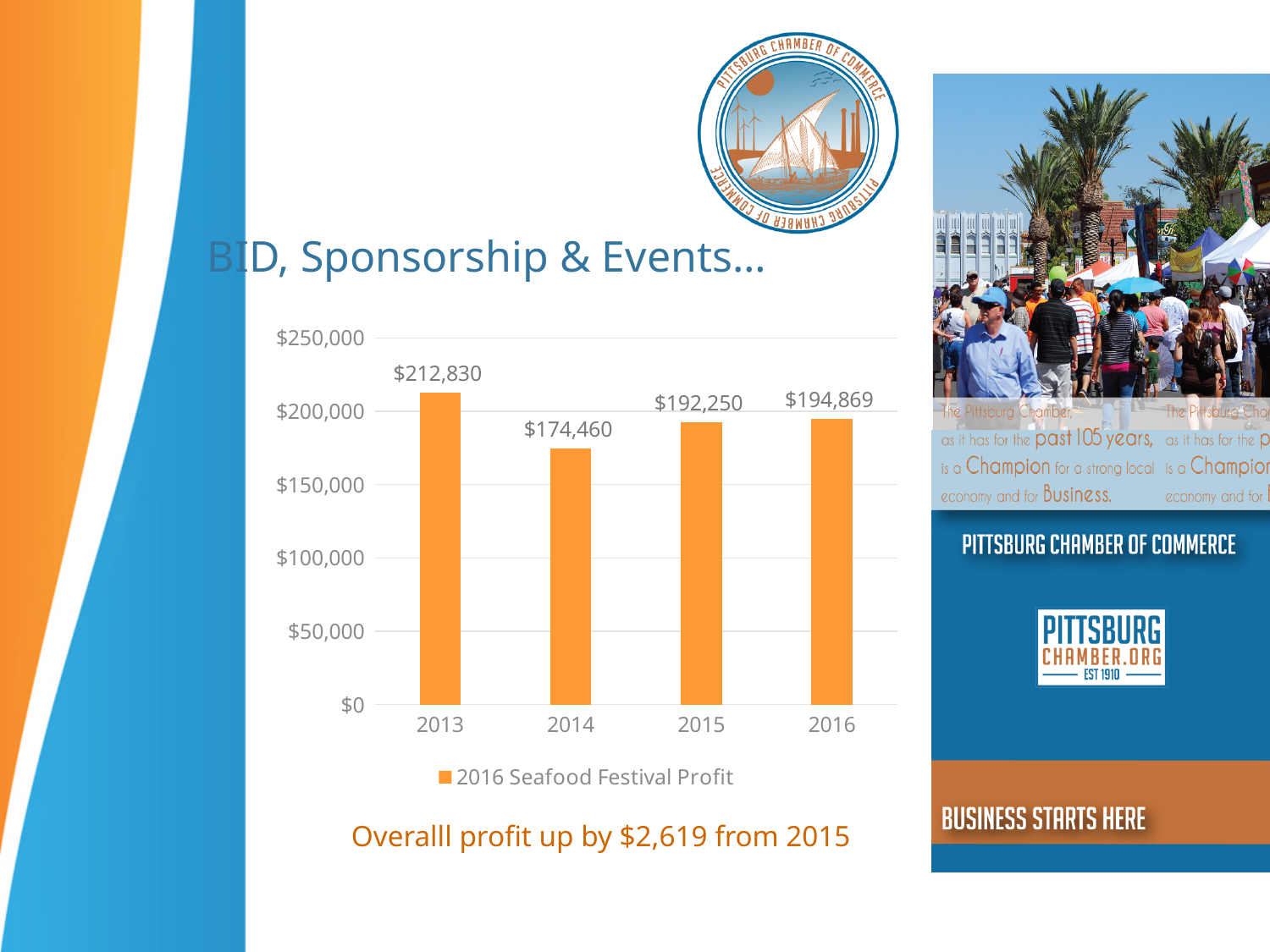
Which year has the highest value? 2013 What is the difference between the values for 2013 and 2014? $38,370 What is the difference between the values for 2016 and 2015? $2,619 Which is larger, the value for 2013 or the value for 2016? 2013 What is the value for 2015? $192,250 What is the value for 2014? $174,460 What is the value for 2016? $194,869 What kind of chart is shown? Bar chart Which year has the lowest value? 2014 What is the value for 2013? $212,830 How many years are shown on the x axis? 4 What series name does the legend show? 2016 Seafood Festival Profit